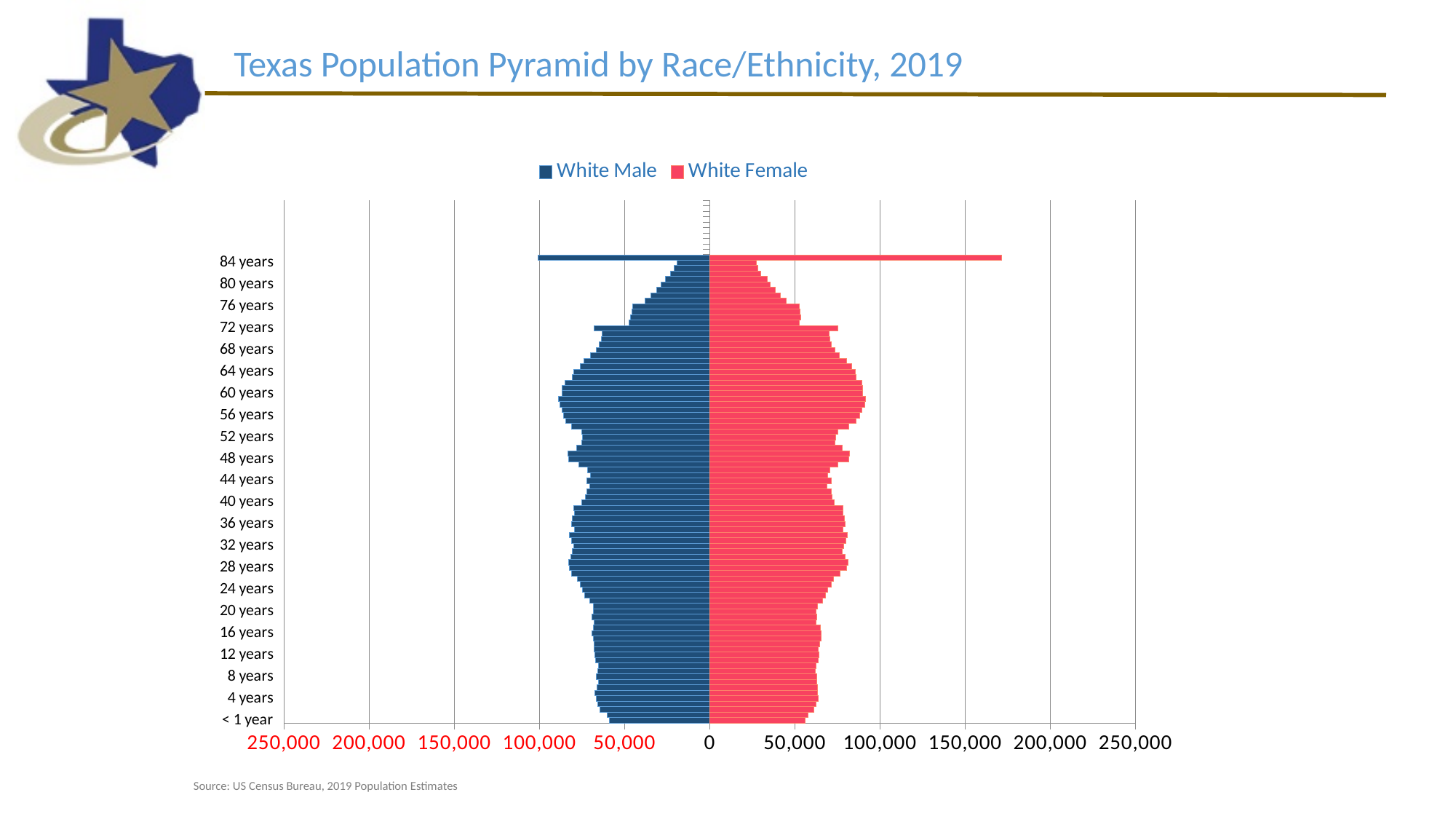
What is the title of the chart? Texas Population Pyramid by Race/Ethnicity, 2019 Is the White Male value for < 1 year greater or less than 100,000? less Between 60 years and 80 years, do the White Female bars get longer or shorter as age increases? shorter Which series is shown in dark blue? White Male What kind of chart is shown on the slide? Bar chart How many series does the legend list? 2 At 84 years, which is larger: the White Male value or the White Female value? White Female Is the White Female value for 72 years greater or less than 100,000? less